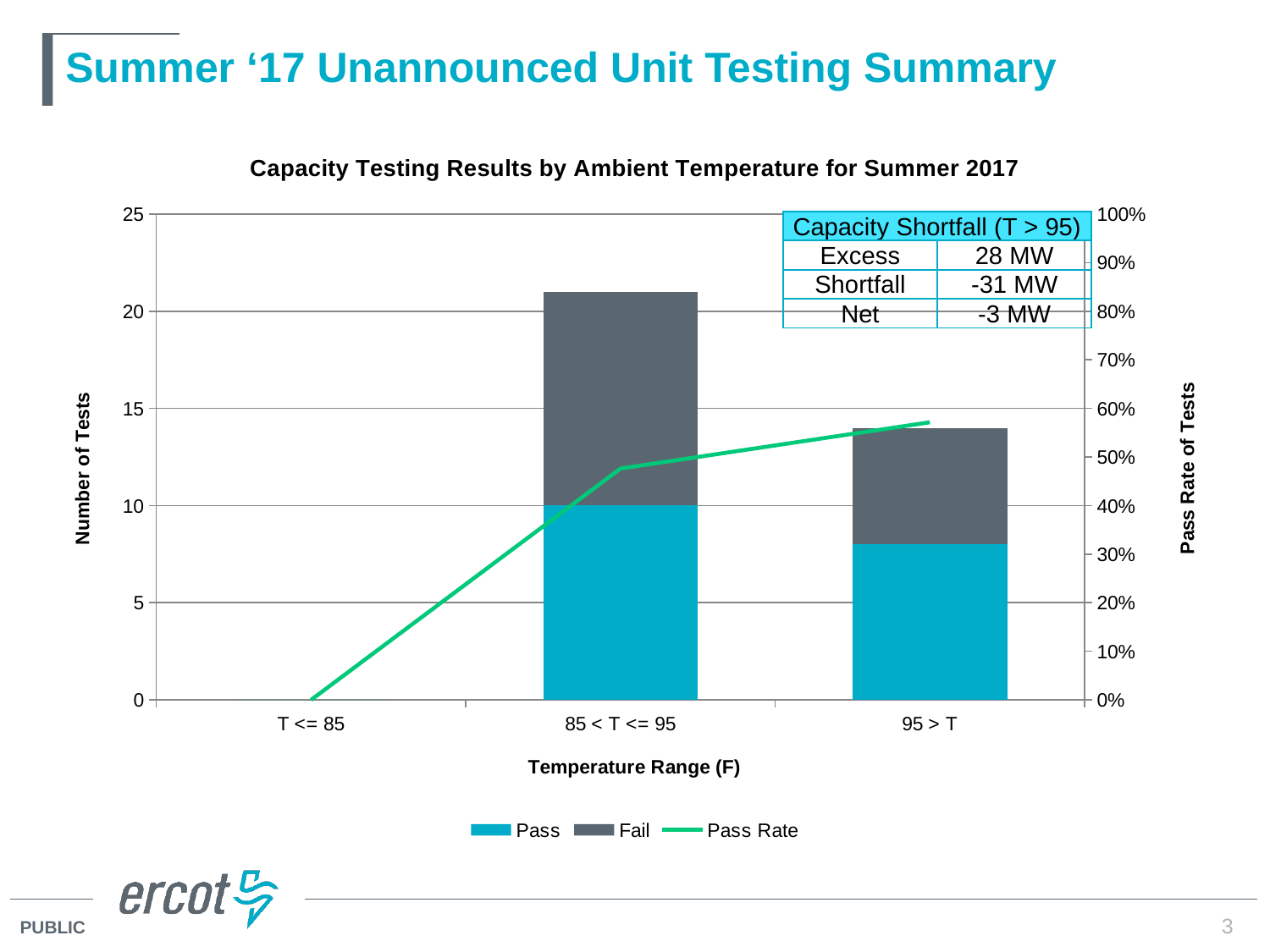
Does the Pass Rate line rise or fall from left to right across the temperature ranges? rise Is the number of Pass tests for 95 > T greater or less than 10? less Is the total number of tests for 85 < T <= 95 greater or less than 20? greater What is the Pass Rate for the T <= 85 temperature range? 0% Is the Pass Rate for 95 > T greater or less than 50%? greater Which temperature range has the highest total number of tests? 85 < T <= 95 How many temperature ranges are shown on the x axis? 3 How many Pass tests are shown for the 85 < T <= 95 temperature range? 10 How many series does the legend list? 3 What is the title of the chart? Capacity Testing Results by Ambient Temperature for Summer 2017 Which has the higher Pass Rate, 85 < T <= 95 or 95 > T? 95 > T What kind of chart is shown on the slide? combination bar and line chart